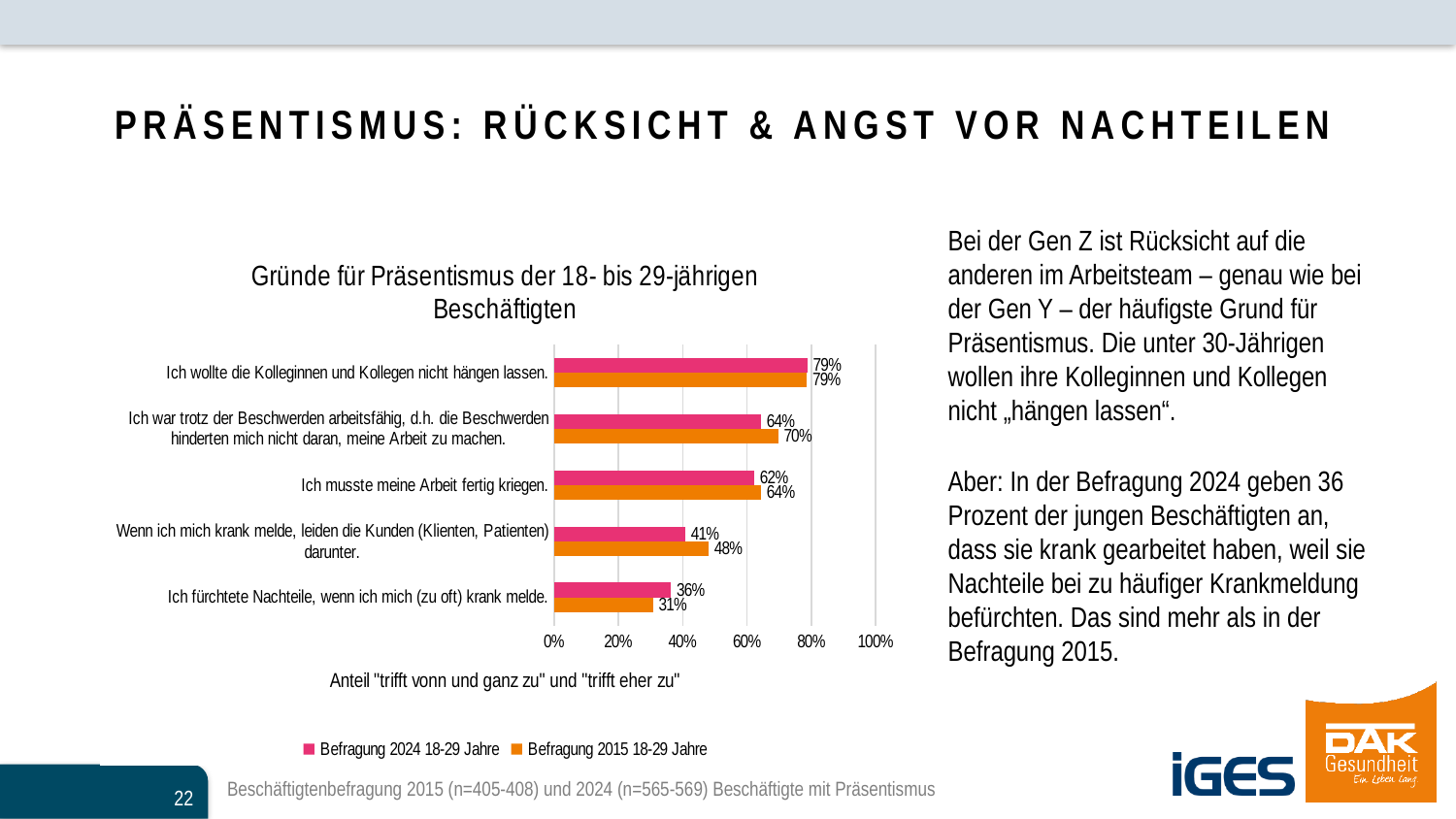
What is the title of the chart? Gründe für Präsentismus der 18- bis 29-jährigen Beschäftigten What is the value for "Ich fürchtete Nachteile, wenn ich mich (zu oft) krank melde." in the Befragung 2024 18-29 Jahre series? 36% How many series does the chart legend list? 2 Which category has the highest value in the Befragung 2024 18-29 Jahre series? Ich wollte die Kolleginnen und Kollegen nicht hängen lassen. What is the value for "Ich fürchtete Nachteile, wenn ich mich (zu oft) krank melde." in the Befragung 2015 18-29 Jahre series? 31% What kind of chart is shown on the slide? bar chart What is the value for "Wenn ich mich krank melde, leiden die Kunden (Klienten, Patienten) darunter." in the Befragung 2015 18-29 Jahre series? 48% For "Wenn ich mich krank melde, leiden die Kunden (Klienten, Patienten) darunter.", which series has the larger value, Befragung 2024 18-29 Jahre or Befragung 2015 18-29 Jahre? Befragung 2015 18-29 Jahre What is the difference between the 2015 and 2024 values for "Ich war trotz der Beschwerden arbeitsfähig, d.h. die Beschwerden hinderten mich nicht daran, meine Arbeit zu machen."? 6% How many categories (reasons) are shown in the chart? 5 Which category has the lowest value in the Befragung 2015 18-29 Jahre series? Ich fürchtete Nachteile, wenn ich mich (zu oft) krank melde. What is the value for "Ich musste meine Arbeit fertig kriegen." in the Befragung 2024 18-29 Jahre series? 62%